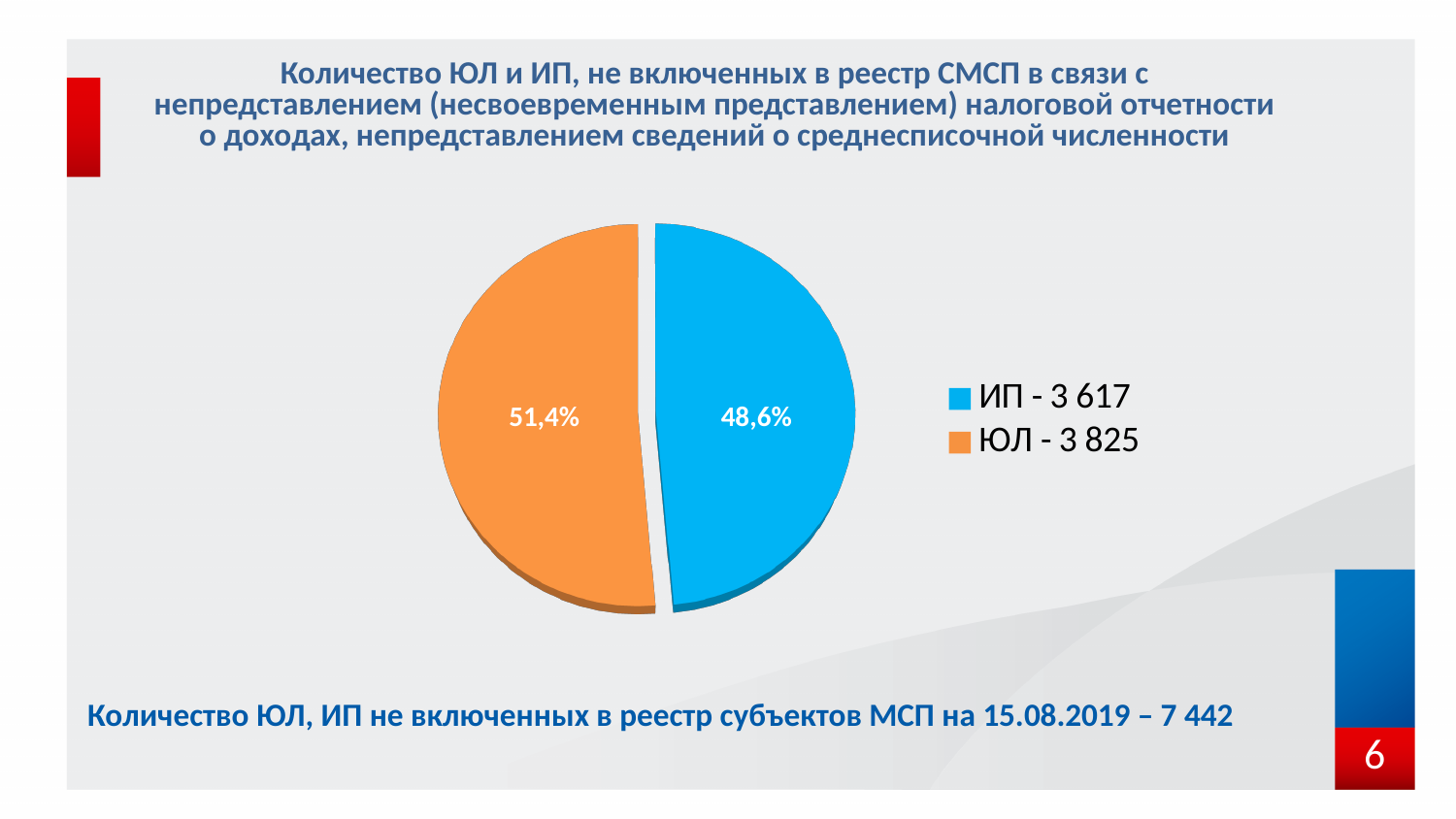
Which slice of the pie chart is the smallest? ИП What count is given for ЮЛ in the legend of the pie chart? 3 825 What percentage share does the ИП slice have in the pie chart? 48,6% What percentage share does the ЮЛ slice have in the pie chart? 51,4% Which slice of the pie chart is the largest? ЮЛ What count is given for ИП in the legend of the pie chart? 3 617 Which is larger in the pie chart, the share for ИП or the share for ЮЛ? ЮЛ How many slices does the pie chart have? 2 What colour is the ИП slice in the pie chart? blue How many entries does the legend of the pie chart list? 2 What is the difference in percentage points between the ЮЛ share and the ИП share in the pie chart? 2,8 What kind of chart is shown on the slide? pie chart